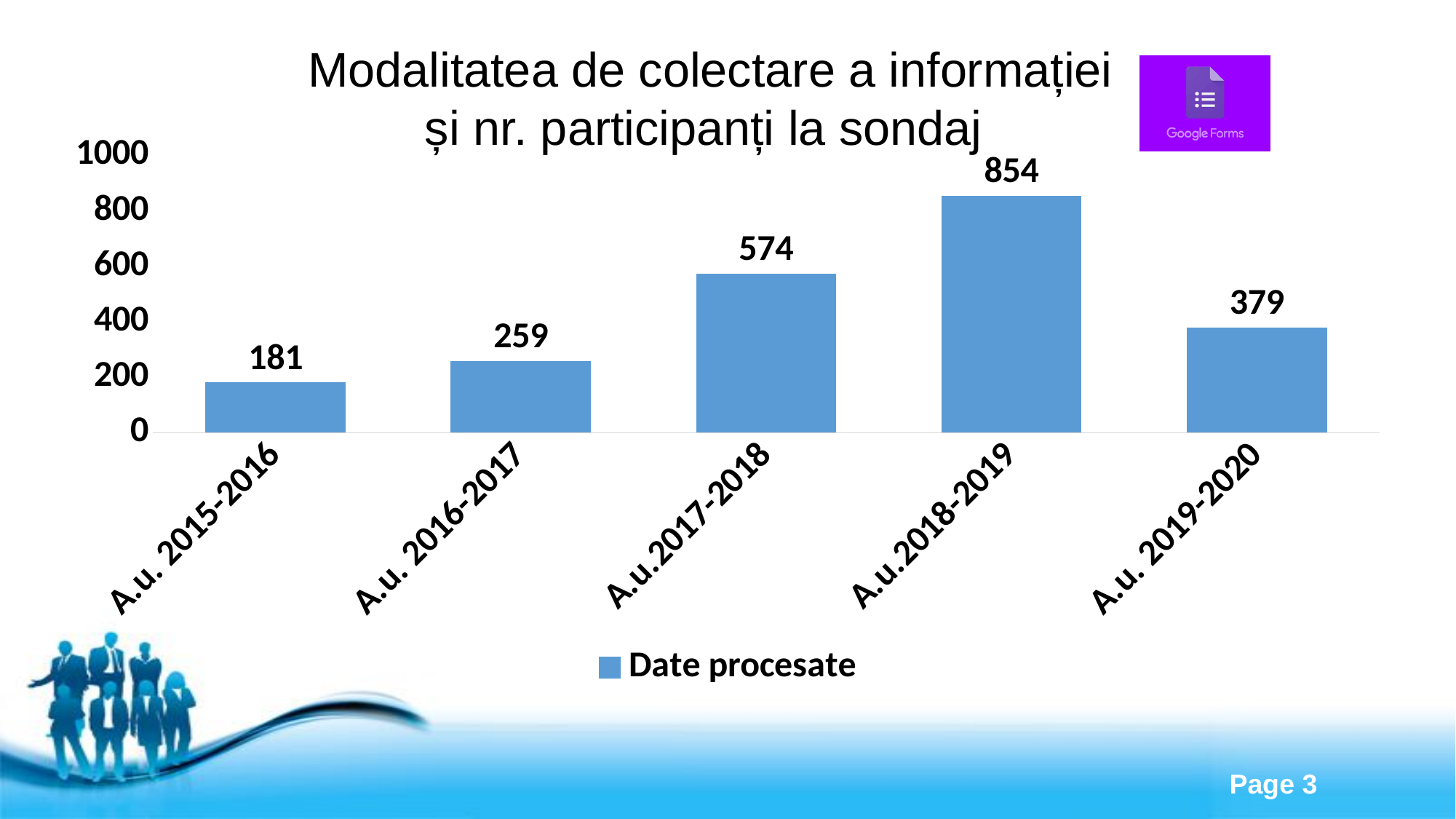
What is the name of the series shown in the legend? Date procesate How many series does the legend list? 1 What is the value for A.u. 2015-2016? 181 How many categories are shown on the x axis? 5 Which is larger, the value for A.u. 2016-2017 or the value for A.u. 2019-2020? A.u. 2019-2020 Which category has the lowest value? A.u. 2015-2016 What is the difference between the values for A.u. 2018-2019 and A.u. 2017-2018? 280 What is the value for A.u. 2018-2019? 854 Is the value for A.u. 2017-2018 greater or less than 400? greater Which category has the highest value? A.u. 2018-2019 What kind of chart is shown on the slide? bar chart What is the value for A.u. 2019-2020? 379